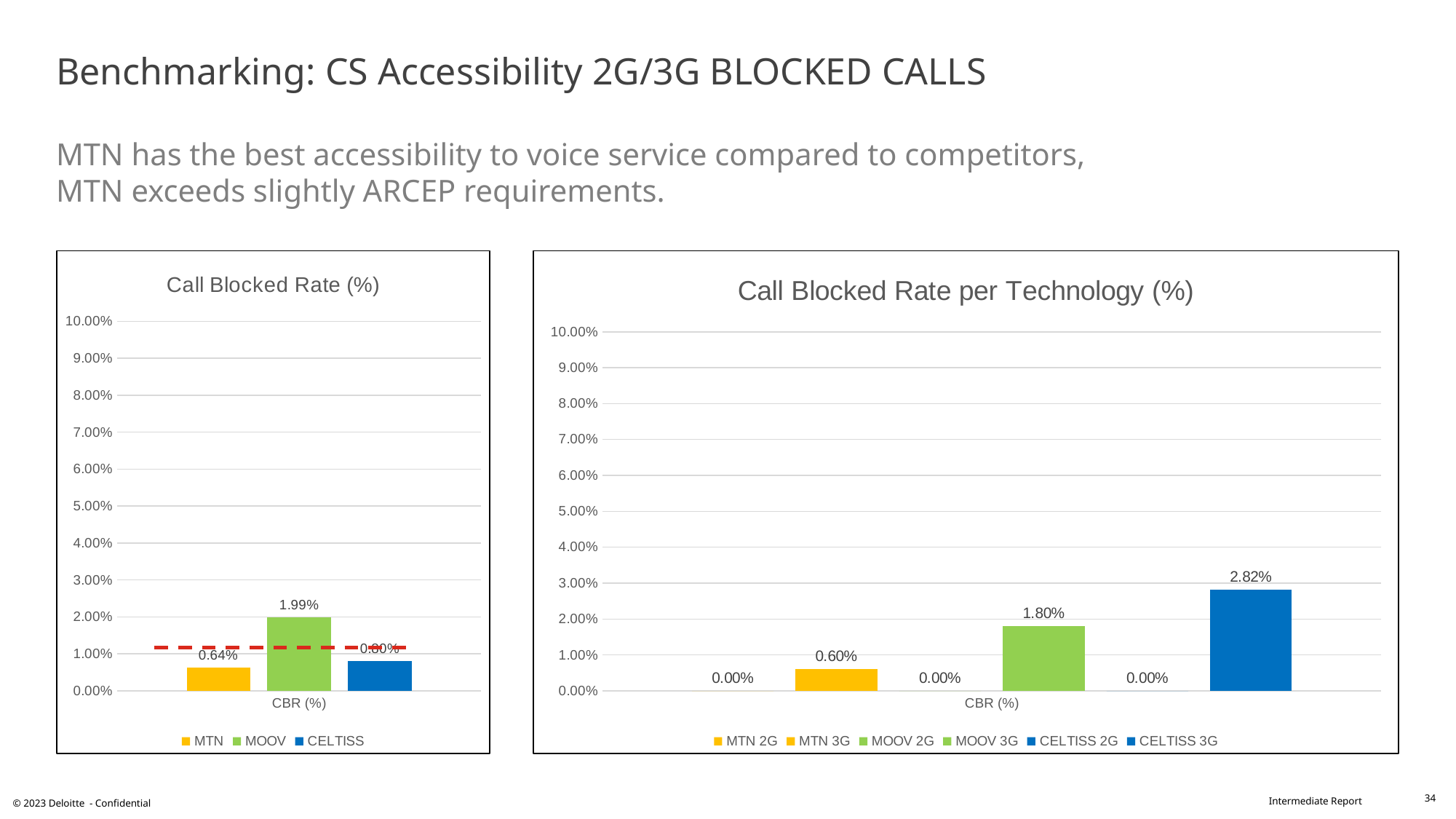
How many series does the legend of the 'Call Blocked Rate per Technology (%)' chart list? 6 In the 'Call Blocked Rate per Technology (%)' chart, what is the value for CELTISS 3G? 2.82% In the 'Call Blocked Rate per Technology (%)' chart, which series has the highest value? CELTISS 3G How many series does the legend of the 'Call Blocked Rate (%)' chart list? 3 In the 'Call Blocked Rate (%)' chart, which operator has the highest call blocked rate? MOOV In the 'Call Blocked Rate (%)' chart, is the value for CELTISS greater or less than 1.00%? less In the 'Call Blocked Rate (%)' chart, what is the difference between the MOOV and MTN values? 1.35% What kind of chart is the 'Call Blocked Rate per Technology (%)' chart? bar chart In the 'Call Blocked Rate per Technology (%)' chart, what is the difference between the CELTISS 3G and MOOV 3G values? 1.02% In the 'Call Blocked Rate (%)' chart, what is the value for MOOV? 1.99% In the 'Call Blocked Rate per Technology (%)' chart, what is the value for MTN 3G? 0.60% In the 'Call Blocked Rate (%)' chart, what is the value for MTN? 0.64%